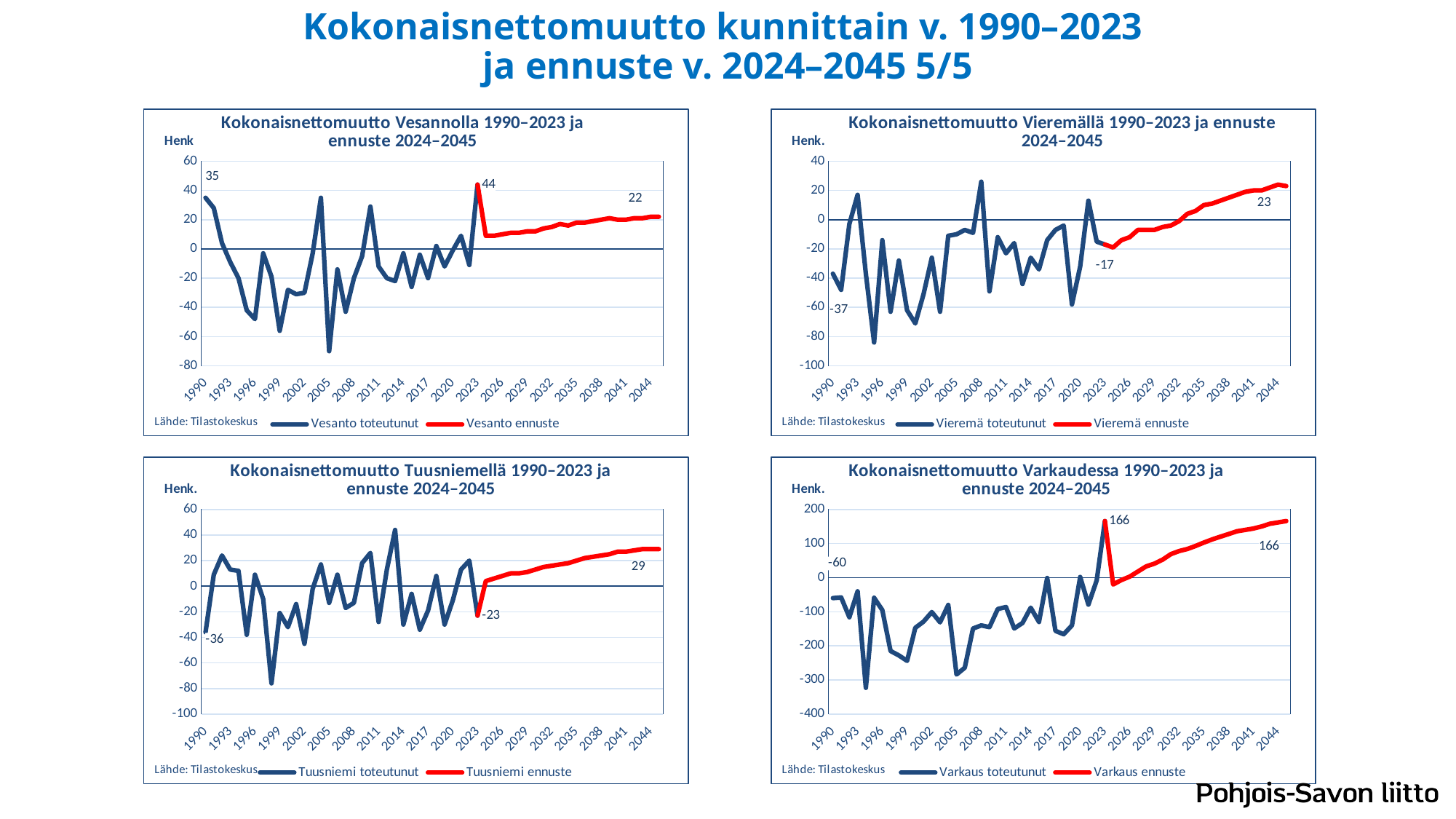
How many series does the legend of the Varkaus chart (bottom right) list? 2 In the Varkaus chart (bottom right), what is the difference between the labelled 2023 value and the labelled 1990 value? 226 In the Vesanto chart (top left), which labelled value is larger: 2023 or 2045? 2023 In the Vieremä chart (top right), what is the labelled forecast value for 2045? 23 In the Vieremä chart (top right), what is the labelled value for 1990? -37 In the Vesanto chart (top left), what is the labelled value for 1990? 35 In the Varkaus chart (bottom right), what is the labelled value for 1990? -60 In the Vieremä chart (top right), does the forecast line rise or fall from 2024 to 2045? Rises What kind of chart is the Vieremä chart (top right)? Line chart In the Vesanto chart (top left), what is the labelled value for 2023? 44 In the Tuusniemi chart (bottom left), what is the difference between the labelled 2045 forecast value and the labelled 2023 value? 52 In the Tuusniemi chart (bottom left), what is the labelled value for 2023? -23